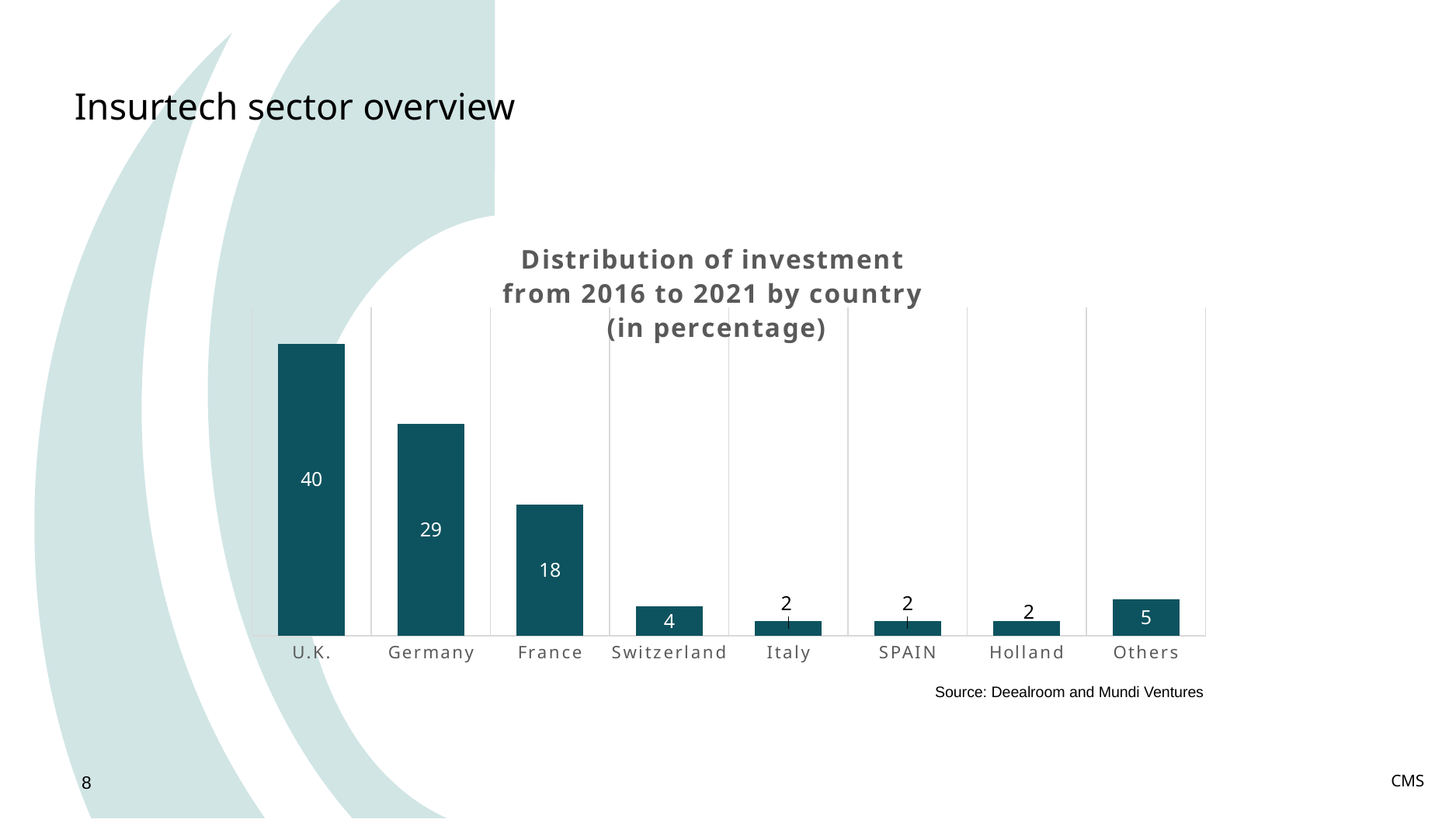
What is the value for France? 18 Which country has the highest value? U.K. What is the title of the chart? Distribution of investment from 2016 to 2021 by country (in percentage) What is the difference between the values for the U.K. and Germany? 11 What kind of chart is shown? Bar chart What is the value for Germany? 29 Which is larger, the value for Switzerland or the value for Others? Others What is the value for Others? 5 What is the value for the U.K.? 40 What is the value for Switzerland? 4 How many categories are shown on the x axis? 8 What is the difference between the values for Germany and France? 11